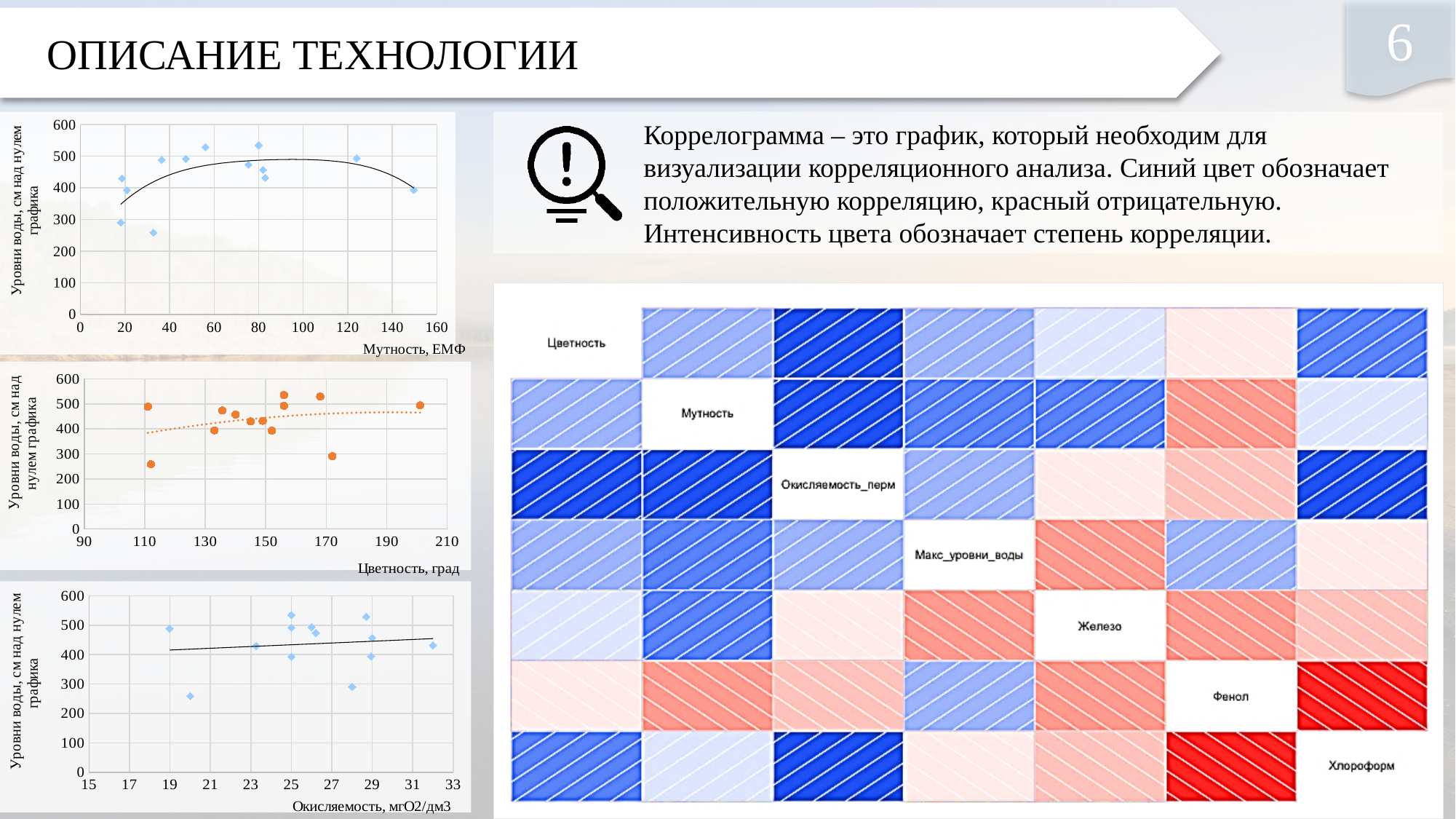
In the bottom-left chart (Окисляемость, мгО2/дм3), is the value of the point at about x = 20 greater or less than 300? less What kind of chart is the top-left chart with x axis 'Мутность, ЕМФ'? scatter chart In the top-left chart (Мутность, ЕМФ), is the value of the point at about x = 33 greater or less than 300? less In the middle-left chart (Цветность, град), is the value of the lowest point, at about x = 112, greater or less than 300? less How many variables are shown on the diagonal of the correlogram on the right? 7 In the correlogram on the right, what colour is the cell for Фенол and Хлороформ? red What is the y-axis label of the bottom-left chart? Уровни воды, см над нулем графика In the bottom-left chart (Окисляемость, мгО2/дм3), does the trend line rise or fall as x increases? rises In the middle-left chart (Цветность, град), does the dotted trend line rise or fall as x increases? rises